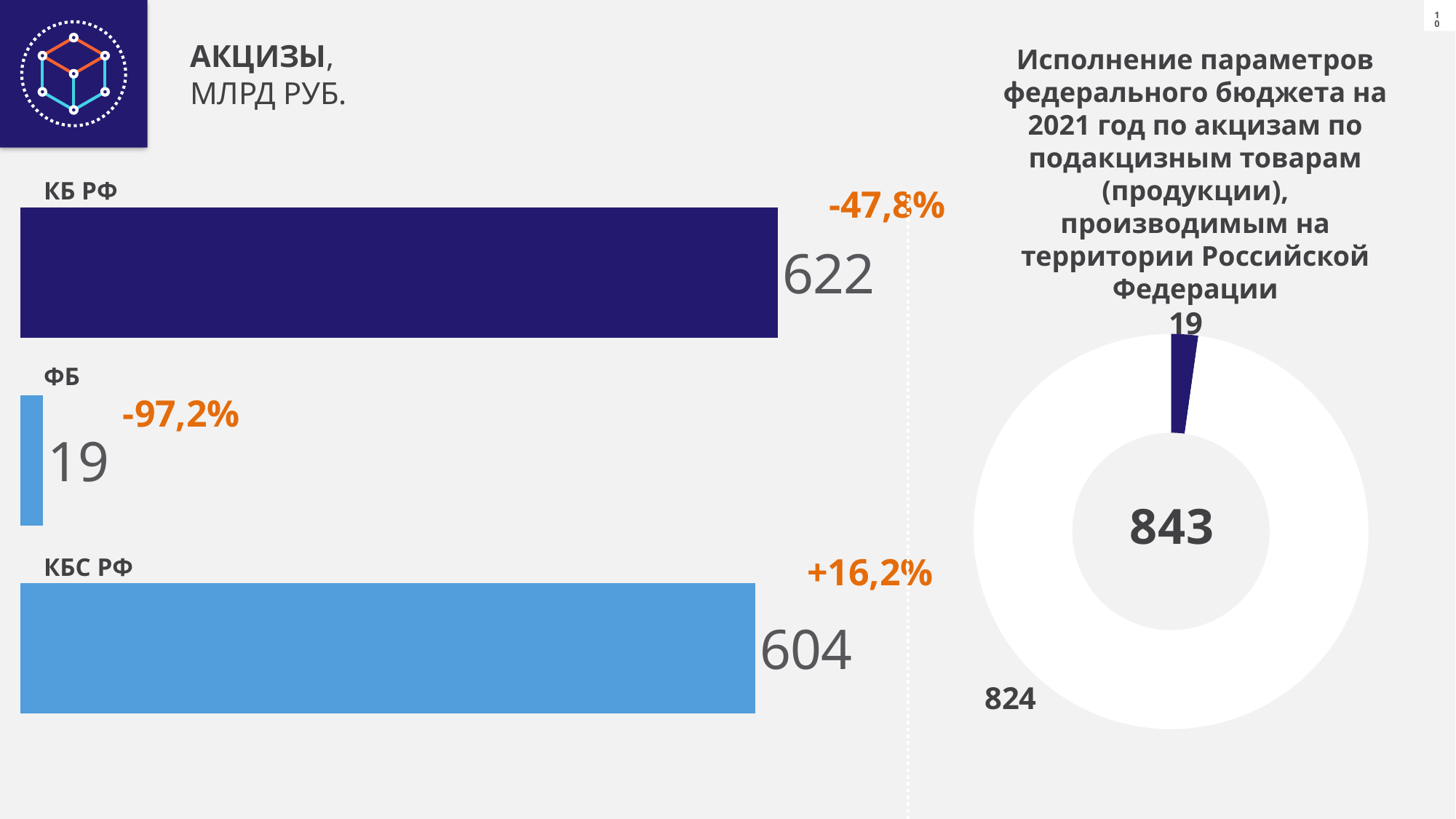
On the bar chart 'АКЦИЗЫ, МЛРД РУБ.', which category has the lowest value? ФБ On the bar chart 'АКЦИЗЫ, МЛРД РУБ.', what is the value for КБС РФ? 604 On the bar chart 'АКЦИЗЫ, МЛРД РУБ.', what percentage change is shown next to the ФБ bar? -97,2% What kind of chart is the chart on the left of the slide? Bar chart On the bar chart 'АКЦИЗЫ, МЛРД РУБ.', what is the value for КБ РФ? 622 On the bar chart 'АКЦИЗЫ, МЛРД РУБ.', what is the difference between the values for КБ РФ and КБС РФ? 18 On the bar chart 'АКЦИЗЫ, МЛРД РУБ.', what is the value for ФБ? 19 On the doughnut chart on the right, what is the value of the larger slice? 824 On the doughnut chart on the right, what number is shown in the centre? 843 How many categories does the bar chart 'АКЦИЗЫ, МЛРД РУБ.' show? 3 On the bar chart 'АКЦИЗЫ, МЛРД РУБ.', which category has the highest value? КБ РФ On the bar chart 'АКЦИЗЫ, МЛРД РУБ.', what percentage change is shown next to the КБС РФ bar? +16,2%